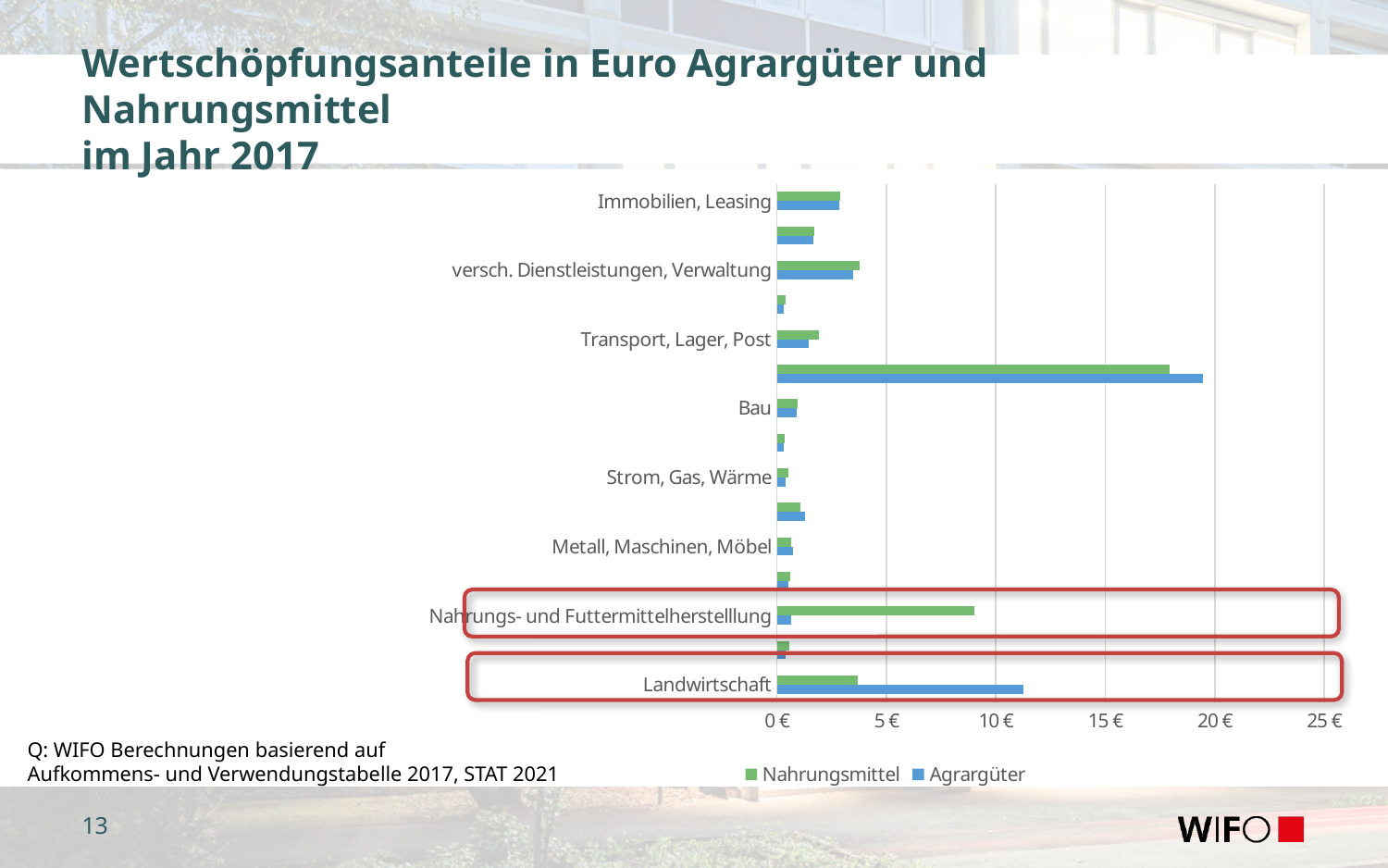
Which has the larger Agrargüter value, Landwirtschaft or Bau? Landwirtschaft For Landwirtschaft, which series has the larger value, Nahrungsmittel or Agrargüter? Agrargüter For Nahrungs- und Futtermittelherstellung, which series has the larger value, Nahrungsmittel or Agrargüter? Nahrungsmittel Which series is shown in green in the legend? Nahrungsmittel Is the Agrargüter value for Landwirtschaft greater or less than 10 €? greater Is the Nahrungsmittel value for Nahrungs- und Futtermittelherstellung greater or less than 10 €? less How many series does the legend list? 2 Is the Nahrungsmittel value for Nahrungs- und Futtermittelherstellung greater or less than 5 €? greater What kind of chart is shown on the slide? bar chart Which series is shown in blue in the legend? Agrargüter